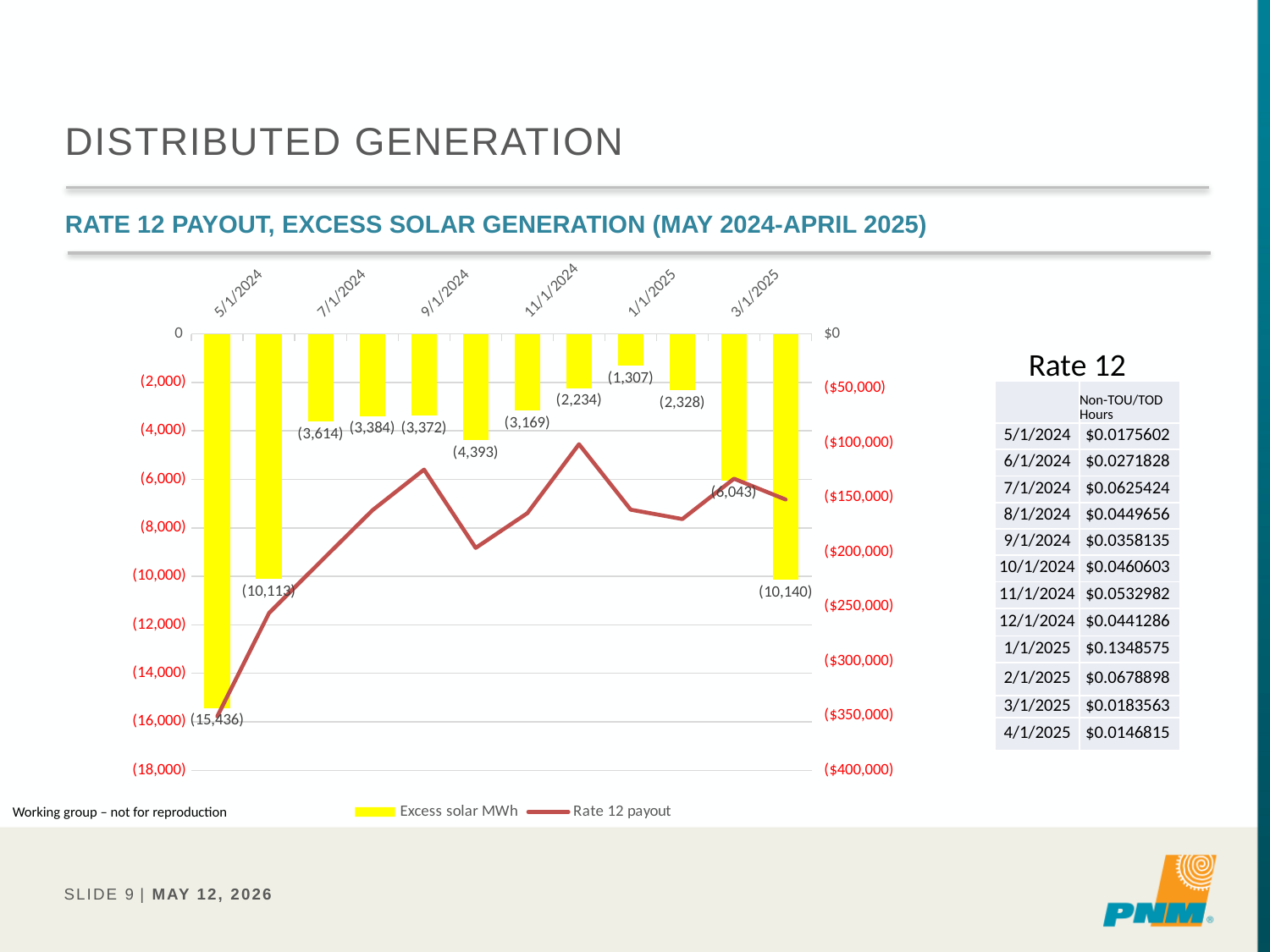
By how much does the magnitude of Excess solar MWh for 5/1/2024 exceed that for 7/1/2024? 11,822 What kind of chart is used for the Rate 12 payout series? Line chart What is the Excess solar MWh value labelled for 1/1/2025? (1,307) What is the Excess solar MWh value labelled for 3/1/2025? (6,043) Is the magnitude of the Rate 12 payout for 5/1/2024 greater or less than $300,000? greater Which month has the longest Excess solar MWh bar (largest magnitude)? 5/1/2024 Which has the larger Excess solar MWh magnitude, 9/1/2024 or 11/1/2024? 9/1/2024 Which month has the shortest Excess solar MWh bar (smallest magnitude)? 1/1/2025 How many series does the chart legend list? 2 How many Excess solar MWh bars are plotted on the chart? 12 What is the Excess solar MWh value labelled for 5/1/2024? (15,436) What is the Excess solar MWh value labelled for 7/1/2024? (3,614)